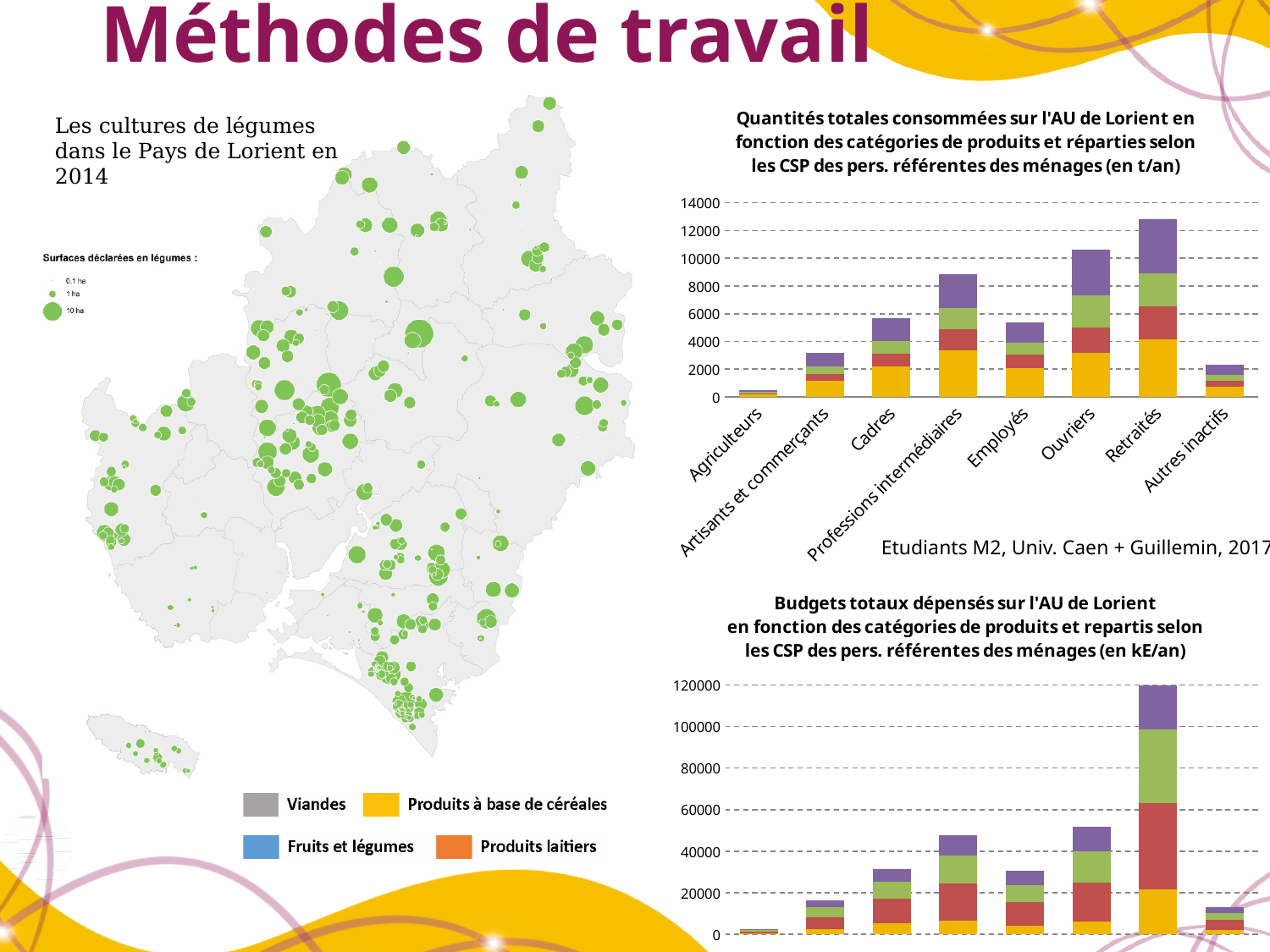
In the top chart (Quantités totales consommées), is the total for Cadres greater or less than 6000? less How many categories (CSP) are shown on the x axis of the top chart (Quantités totales consommées)? 8 In the top chart (Quantités totales consommées sur l'AU de Lorient), which category has the shortest bar? Agriculteurs In the top chart (Quantités totales consommées), which bar is taller: Ouvriers or Employés? Ouvriers In the top chart (Quantités totales consommées), is the total for Professions intermédiaires greater or less than 8000? greater What kind of chart is the bottom chart (Budgets totaux dépensés sur l'AU de Lorient)? stacked bar chart In the top chart (Quantités totales consommées), is the total for Ouvriers greater or less than 10000? greater In the top chart (Quantités totales consommées sur l'AU de Lorient), which category has the tallest bar? Retraités How many entries does the legend at the bottom of the slide list? 4